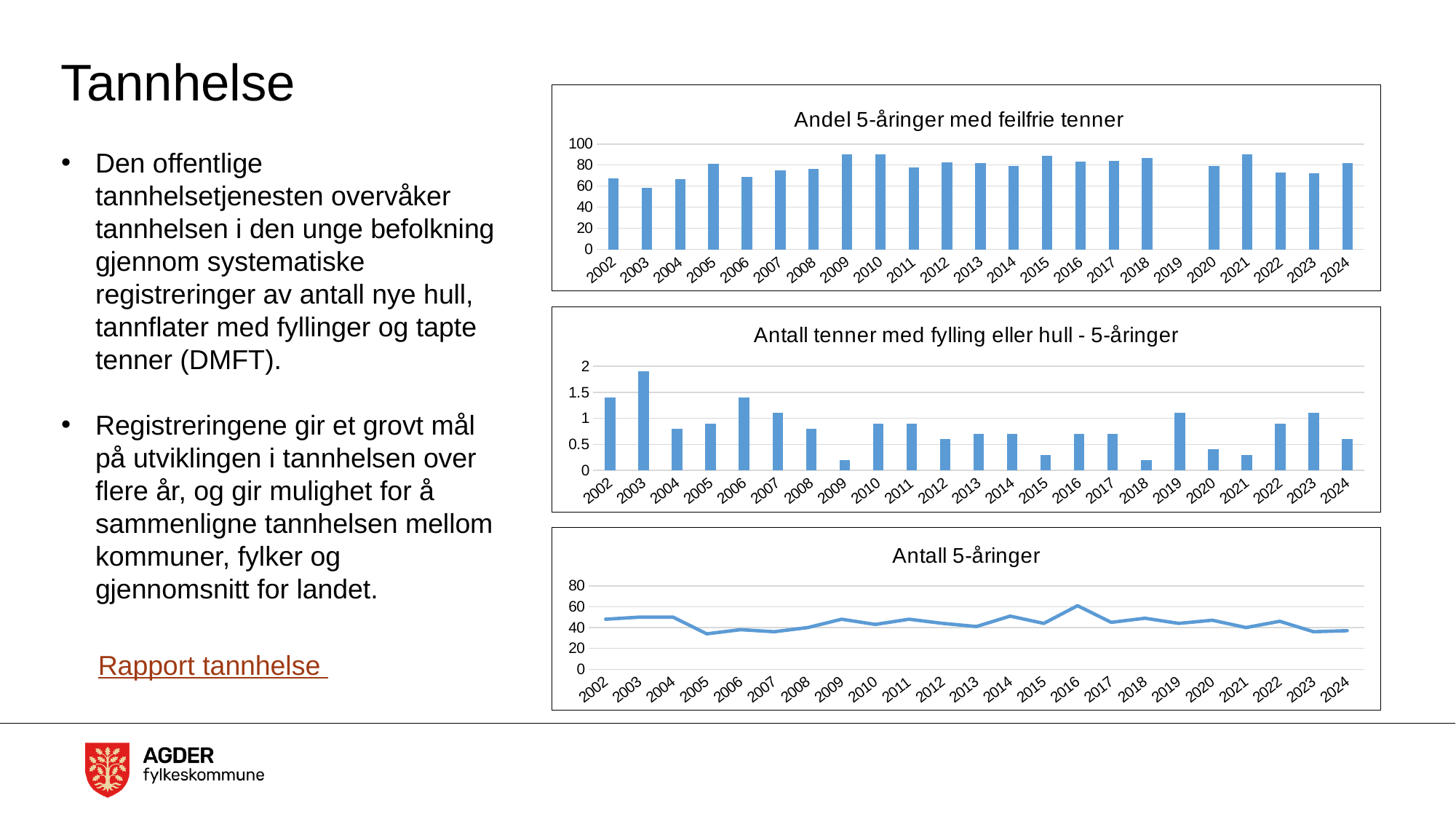
What kind of chart is the top chart, 'Andel 5-åringer med feilfrie tenner'? bar chart In the top chart 'Andel 5-åringer med feilfrie tenner', is the value for 2009 greater or less than 80? greater How many years are shown on the x axis of the bottom chart 'Antall 5-åringer'? 23 In the middle chart 'Antall tenner med fylling eller hull - 5-åringer', is the value for 2003 greater or less than 1.5? greater In the bottom chart 'Antall 5-åringer', is the value for 2005 greater or less than 40? less What kind of chart is the bottom chart, 'Antall 5-åringer'? line chart In the middle chart 'Antall tenner med fylling eller hull - 5-åringer', which year has the highest value? 2003 In the top chart 'Andel 5-åringer med feilfrie tenner', which year has the lowest value? 2003 In the top chart 'Andel 5-åringer med feilfrie tenner', which year has no bar shown? 2019 In the bottom chart 'Antall 5-åringer', which year has the highest value? 2016 In the middle chart 'Antall tenner med fylling eller hull - 5-åringer', which is larger, the value for 2002 or the value for 2004? 2002